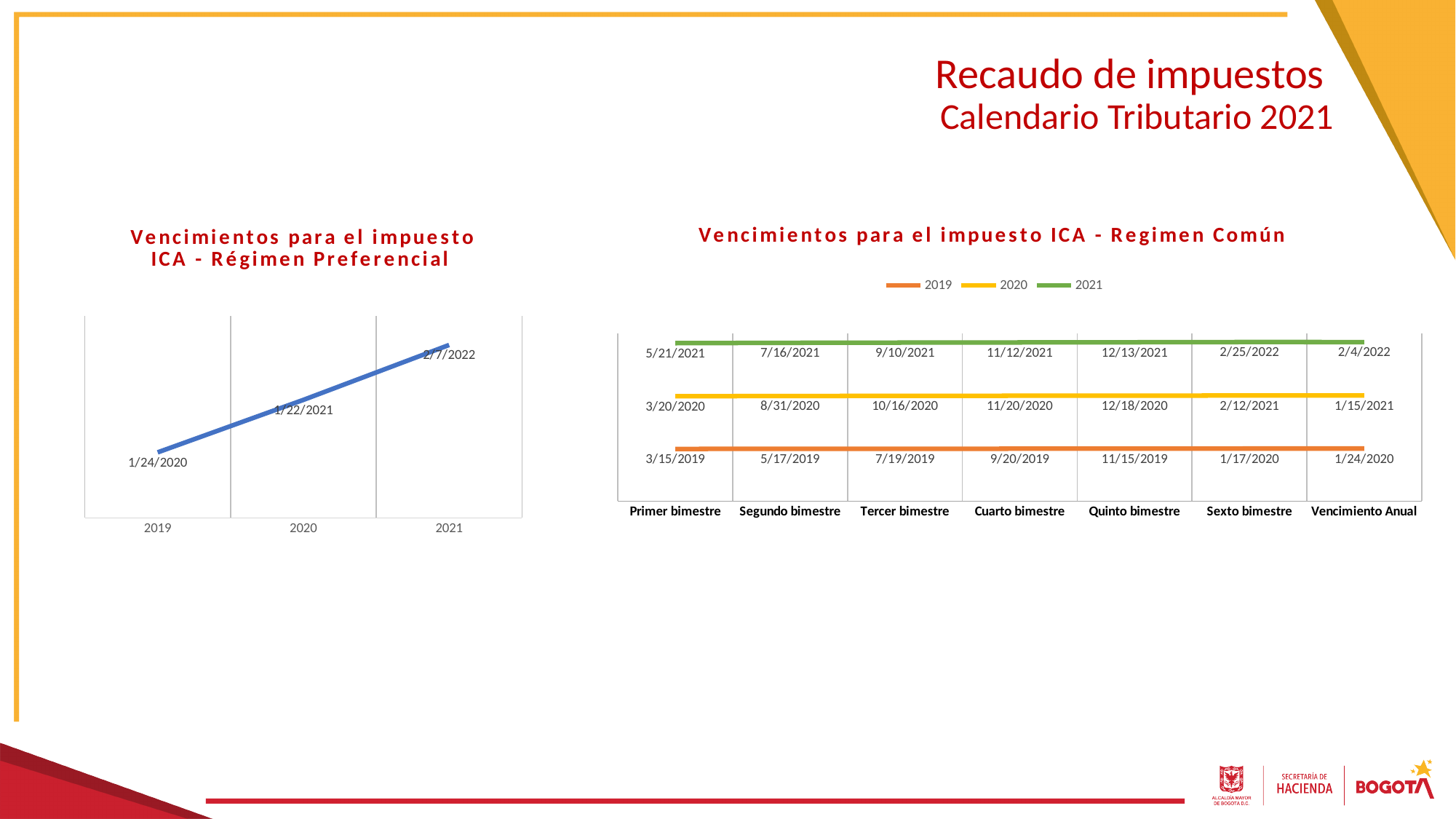
How many series does the legend of the chart 'Vencimientos para el impuesto ICA - Regimen Común' list? 3 In the chart 'Vencimientos para el impuesto ICA - Regimen Común', what is the 2020 value for Vencimiento Anual? 1/15/2021 In the chart 'Vencimientos para el impuesto ICA - Regimen Común', which colour is used for the 2020 series? yellow In the chart 'Vencimientos para el impuesto ICA - Regimen Común', what is the 2019 value for Quinto bimestre? 11/15/2019 In the chart 'Vencimientos para el impuesto ICA - Régimen Preferencial', what is the value for 2020? 1/22/2021 In the chart 'Vencimientos para el impuesto ICA - Régimen Preferencial', what is the value for 2019? 1/24/2020 In the chart 'Vencimientos para el impuesto ICA - Régimen Preferencial', what is the value for 2021? 2/7/2022 In the chart 'Vencimientos para el impuesto ICA - Regimen Común', what is the 2021 value for Sexto bimestre? 2/25/2022 What kind of chart is 'Vencimientos para el impuesto ICA - Régimen Preferencial'? line chart How many categories are shown on the x axis of the chart 'Vencimientos para el impuesto ICA - Regimen Común'? 7 In the chart 'Vencimientos para el impuesto ICA - Regimen Común', what is the 2021 value for Tercer bimestre? 9/10/2021 In the chart 'Vencimientos para el impuesto ICA - Régimen Preferencial', does the line rise or fall from 2019 to 2021? rise